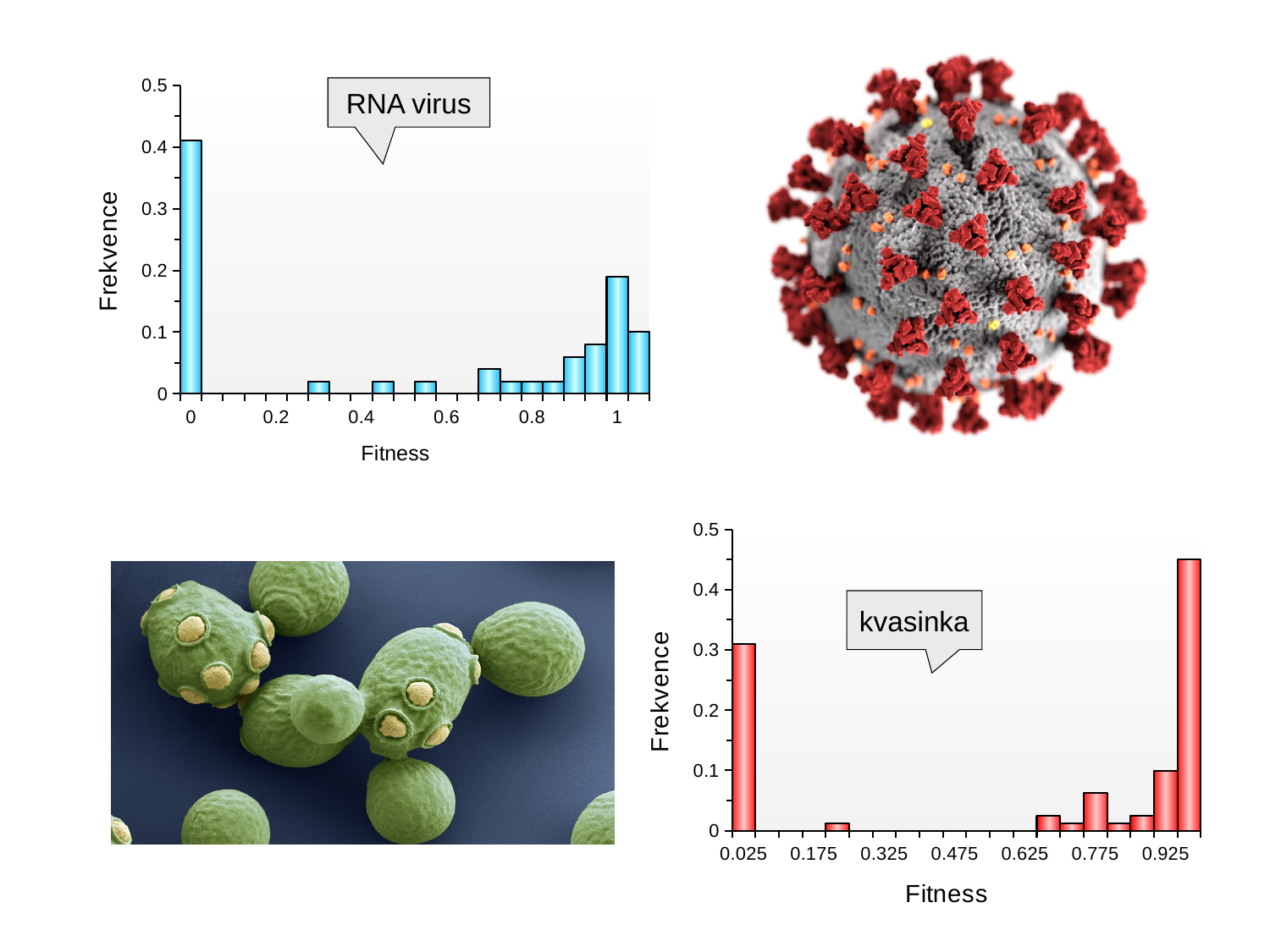
What is the y-axis title of the kvasinka chart? Frekvence In the kvasinka chart, which bar is taller: the one at fitness 0.025 or the rightmost bar? the rightmost bar What colour are the bars in the RNA virus chart? blue In the RNA virus chart, which bar is taller: the one at fitness 0 or the one at fitness 1? fitness 0 In the kvasinka chart, is the tallest bar at the left end or the right end of the x axis? right end What kind of chart is the RNA virus chart? bar chart In the RNA virus chart, which fitness value has the highest frequency? 0 In the kvasinka chart, is the value of the bar at fitness 0.775 greater or less than 0.1? less In the kvasinka chart, is the tallest bar greater or less than 0.4? greater